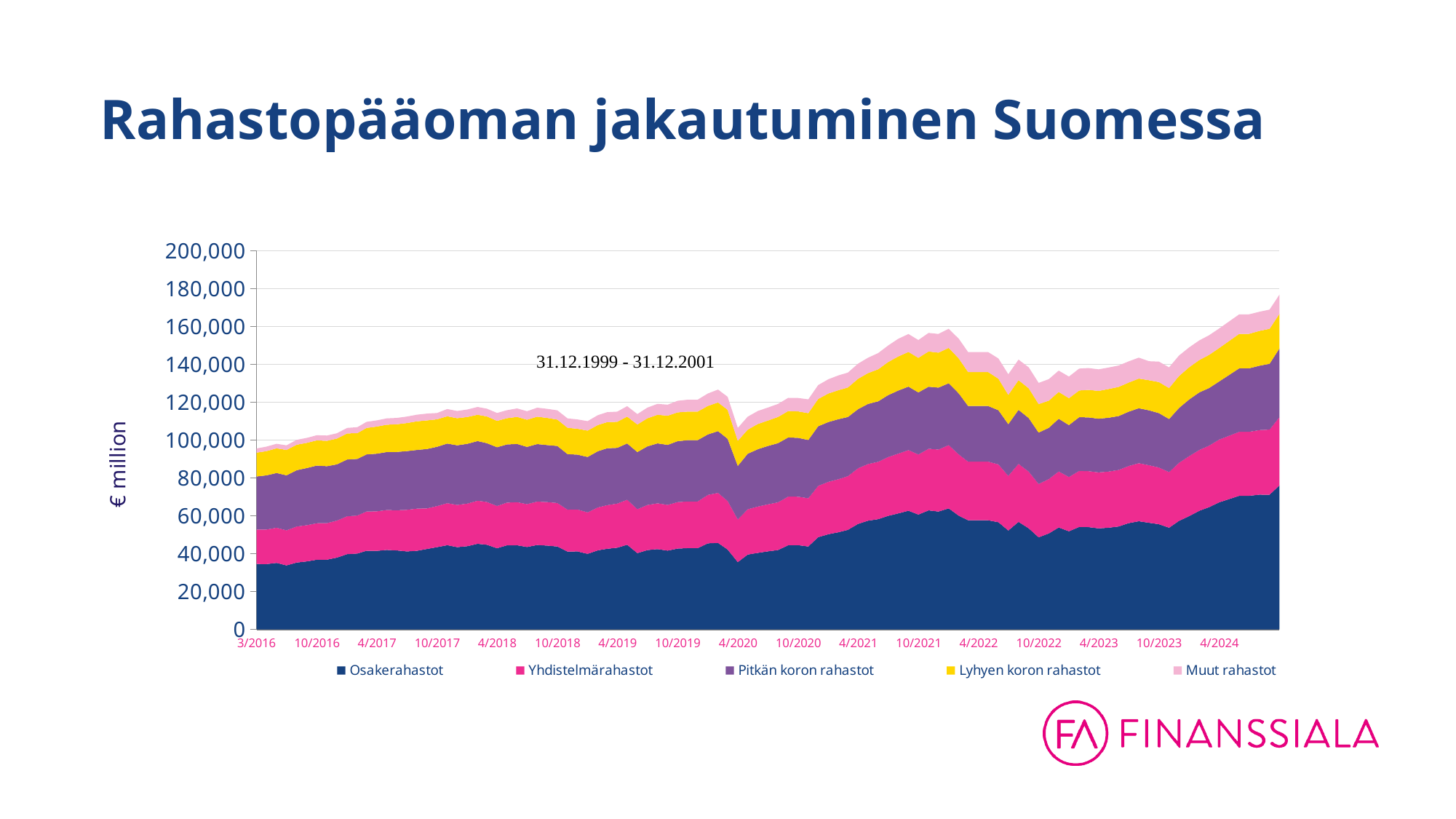
Is the stacked total at 3/2016 greater or less than 100,000? less What is the highest value shown on the vertical axis? 200,000 How many series does the legend list? 5 Is the value for Osakerahastot at 3/2016 greater or less than 40,000? less What kind of chart is shown on the slide? Stacked area chart Is the value for Osakerahastot at the last point of the chart greater or less than 60,000? greater What is the label on the vertical axis? € million Is the stacked total at 10/2021 larger or smaller than the stacked total at 4/2020? larger Does the stacked total generally rise or fall from 3/2016 to the end of the chart? rise Which series is the largest component of the stacked total throughout the chart? Osakerahastot What is the title of the chart? Rahastopääoman jakautuminen Suomessa